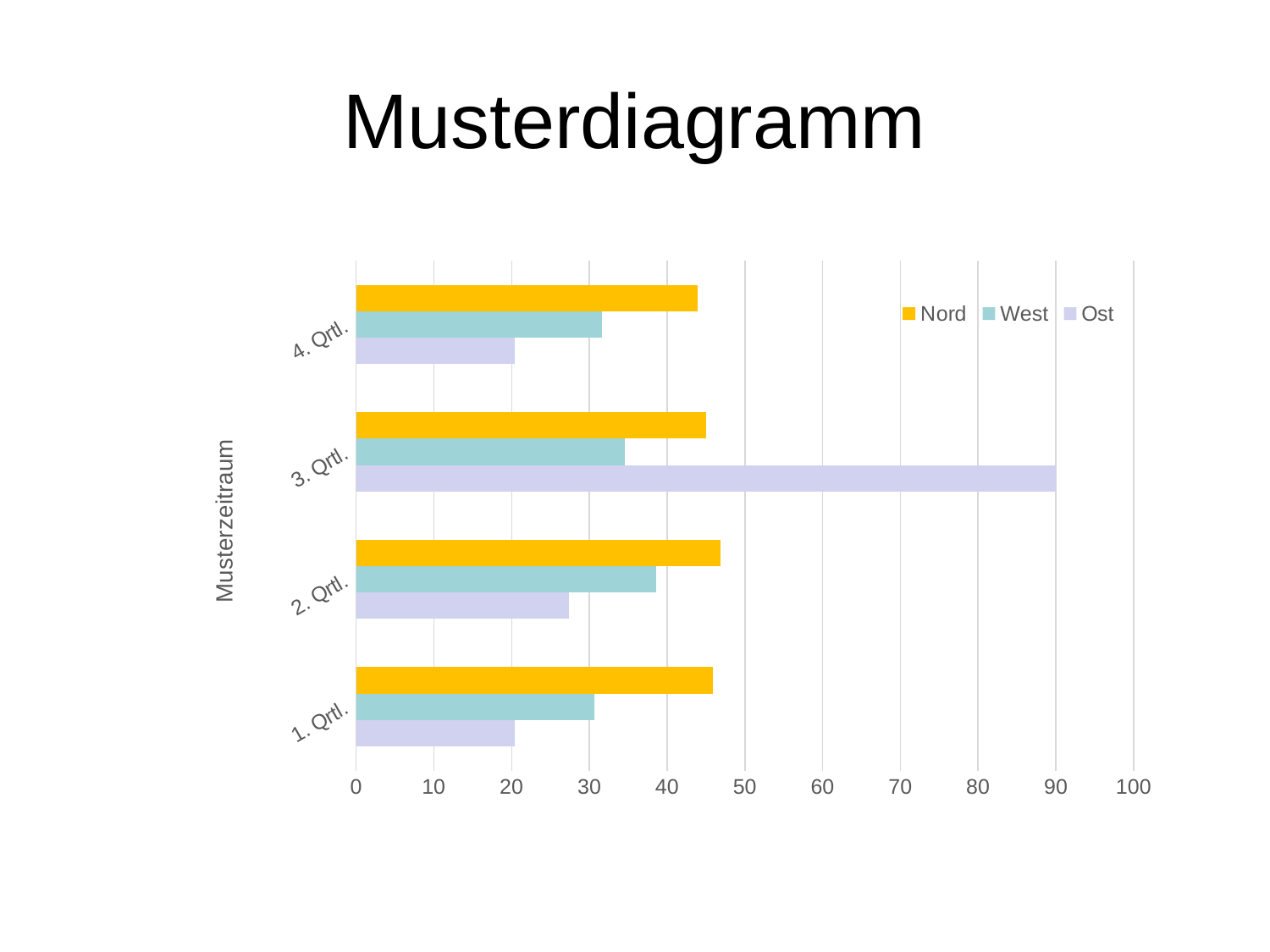
What kind of chart is shown on the slide? bar chart What is the value for Ost in 3. Qrtl.? 90 How many series does the legend list? 3 How many categories are shown on the vertical axis? 4 Which is larger in 2. Qrtl., the value for Nord or the value for Ost? Nord What is the title of the chart? Musterdiagramm Is the value for Nord in 1. Qrtl. greater or less than 40? greater Which is larger in 3. Qrtl., the value for Ost or the value for West? Ost Is the value for West in 2. Qrtl. greater or less than 30? greater In which quarter is the value for Ost highest? 3. Qrtl. Is the value for Ost in 4. Qrtl. greater or less than 30? less What is the label of the vertical axis? Musterzeitraum